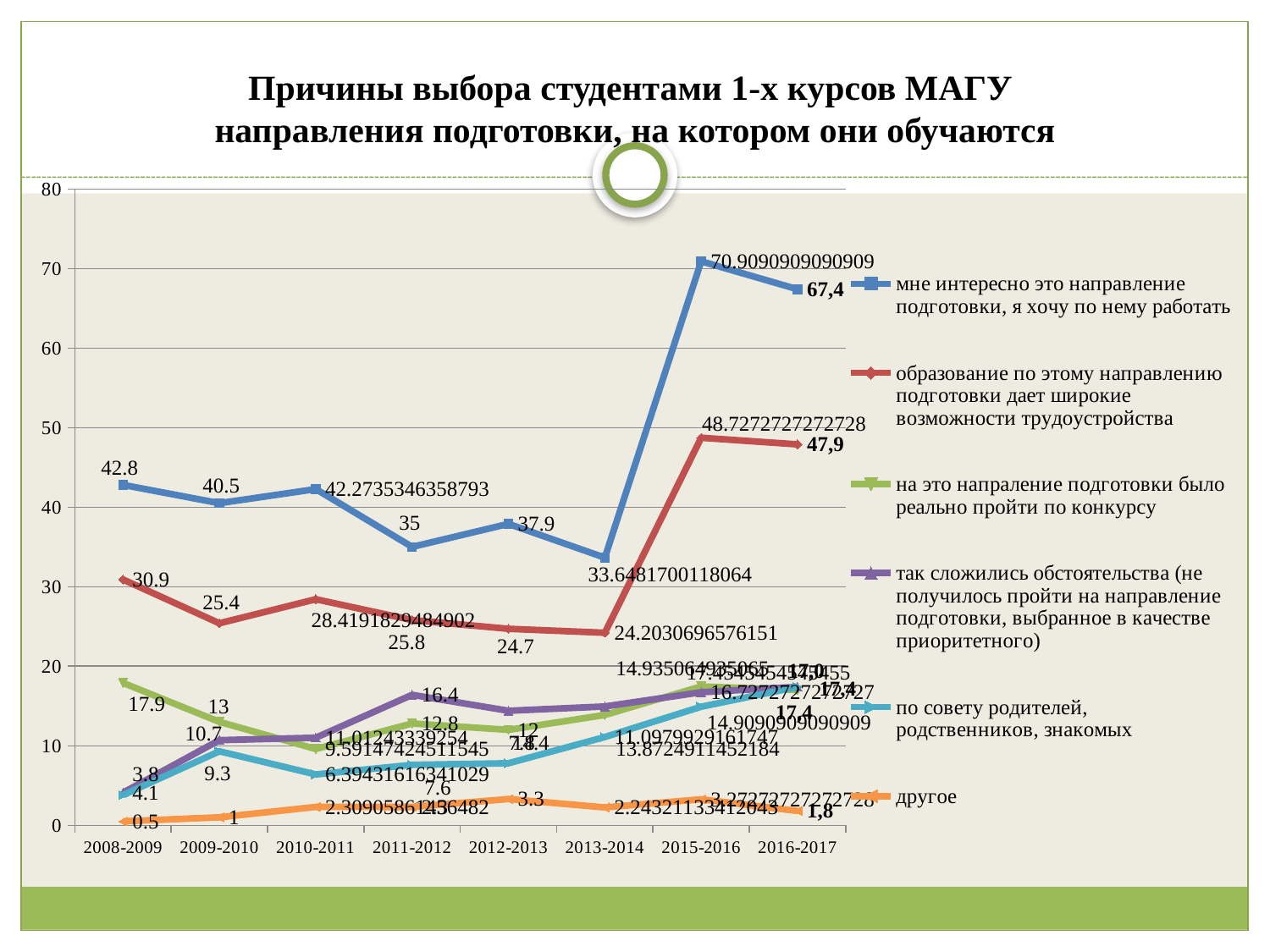
In which academic year does the series "мне интересно это направление подготовки, я хочу по нему работать" reach its highest value? 2015-2016 How many academic-year categories are shown on the x axis? 8 What is the difference between the 2008-2009 and 2009-2010 values of the series "образование по этому направлению подготовки дает широкие возможности трудоустройства"? 5.5 Is the 2015-2016 value for the series "образование по этому направлению подготовки дает широкие возможности трудоустройства" greater or less than 40? greater In 2016-2017, which series has the larger value: "мне интересно это направление подготовки, я хочу по нему работать" or "образование по этому направлению подготовки дает широкие возможности трудоустройства"? мне интересно это направление подготовки, я хочу по нему работать What kind of chart is shown on the slide? line chart How many series does the legend list? 6 In which academic year does the series "мне интересно это направление подготовки, я хочу по нему работать" have its lowest value? 2013-2014 What is the value for 2008-2009 in the series "мне интересно это направление подготовки, я хочу по нему работать"? 42.8 What is the value for 2016-2017 in the series "образование по этому направлению подготовки дает широкие возможности трудоустройства"? 47,9 Which colour is used for the series "другое"? orange What is the value for 2012-2013 in the series "другое"? 3.3